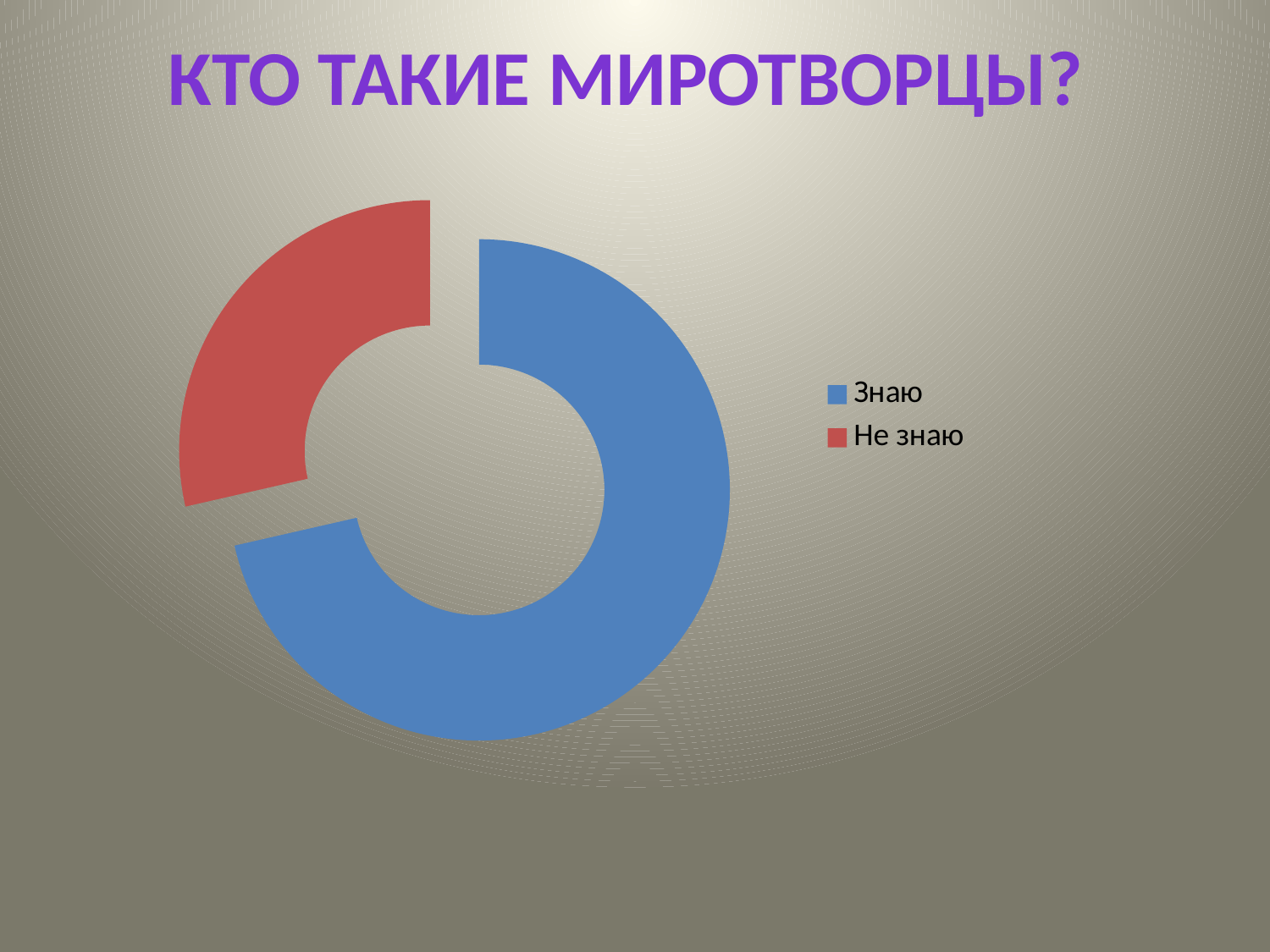
How many entries does the legend list? 2 Which category has the smallest share of the chart? Не знаю Which category has the largest share of the chart? Знаю How many categories does the chart show? 2 Which is larger, the share for Знаю or the share for Не знаю? Знаю What kind of chart is shown on the slide? Doughnut chart What is the title of the slide above the chart? КТО ТАКИЕ МИРОТВОРЦЫ? What colour represents the category Не знаю in the chart? Red